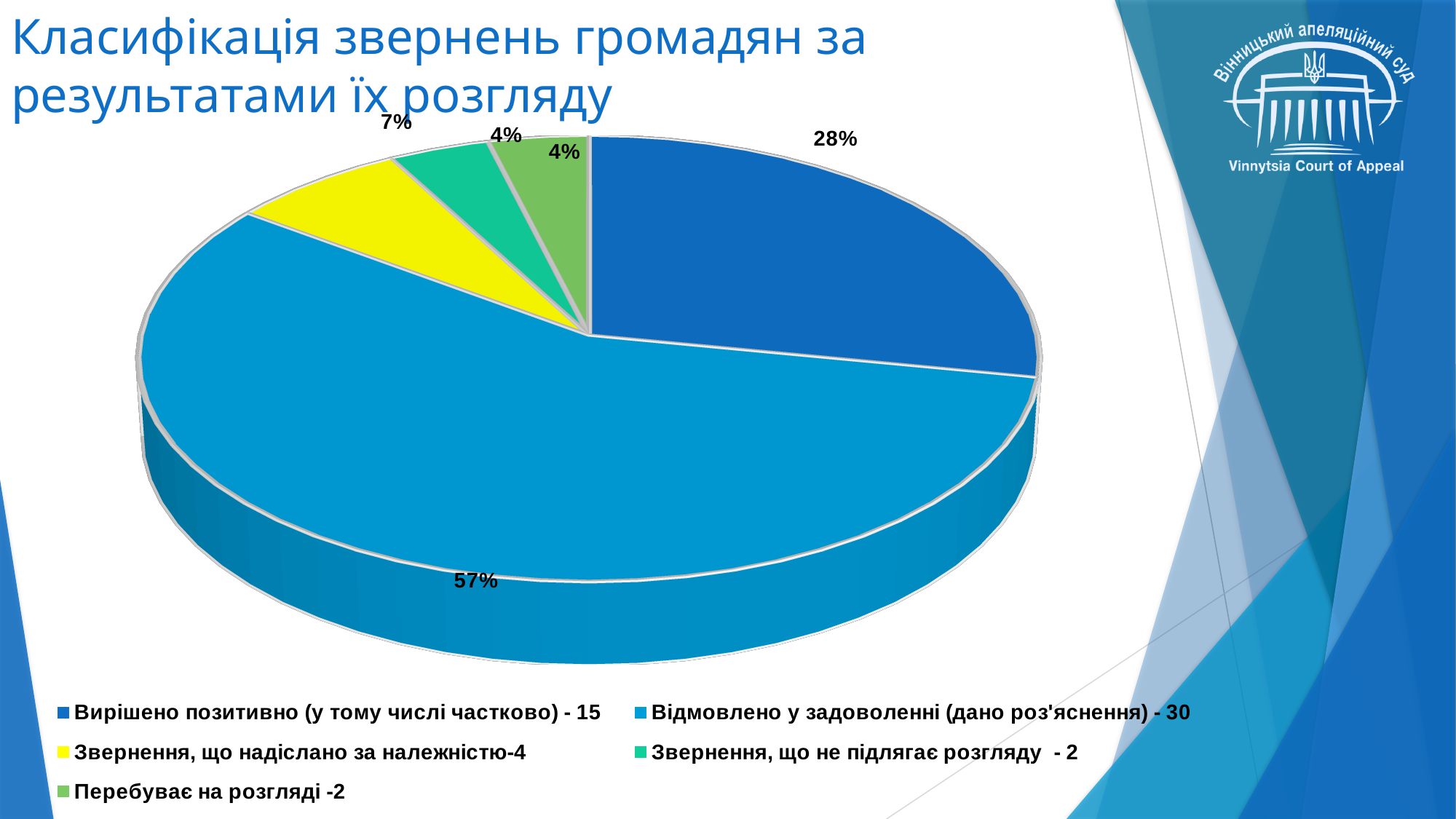
What share of the pie does "Звернення, що надіслано за належністю" take? 7% What is the difference in percentage points between the "Відмовлено у задоволенні (дано роз'яснення)" slice and the "Вирішено позитивно (у тому числі частково)" slice? 29 How many entries does the legend list? 5 Which category has the largest slice of the pie? Відмовлено у задоволенні (дано роз'яснення) What share of the pie does "Перебуває на розгляді" take? 4% How many slices does the pie chart have? 5 Which slice is larger: "Звернення, що надіслано за належністю" or "Звернення, що не підлягає розгляду"? Звернення, що надіслано за належністю What kind of chart is shown on the slide? pie chart What colour is the slice for "Звернення, що надіслано за належністю"? yellow What share of the pie does "Вирішено позитивно (у тому числі частково)" take? 28% What is the title of the slide containing the chart? Класифікація звернень громадян за результатами їх розгляду